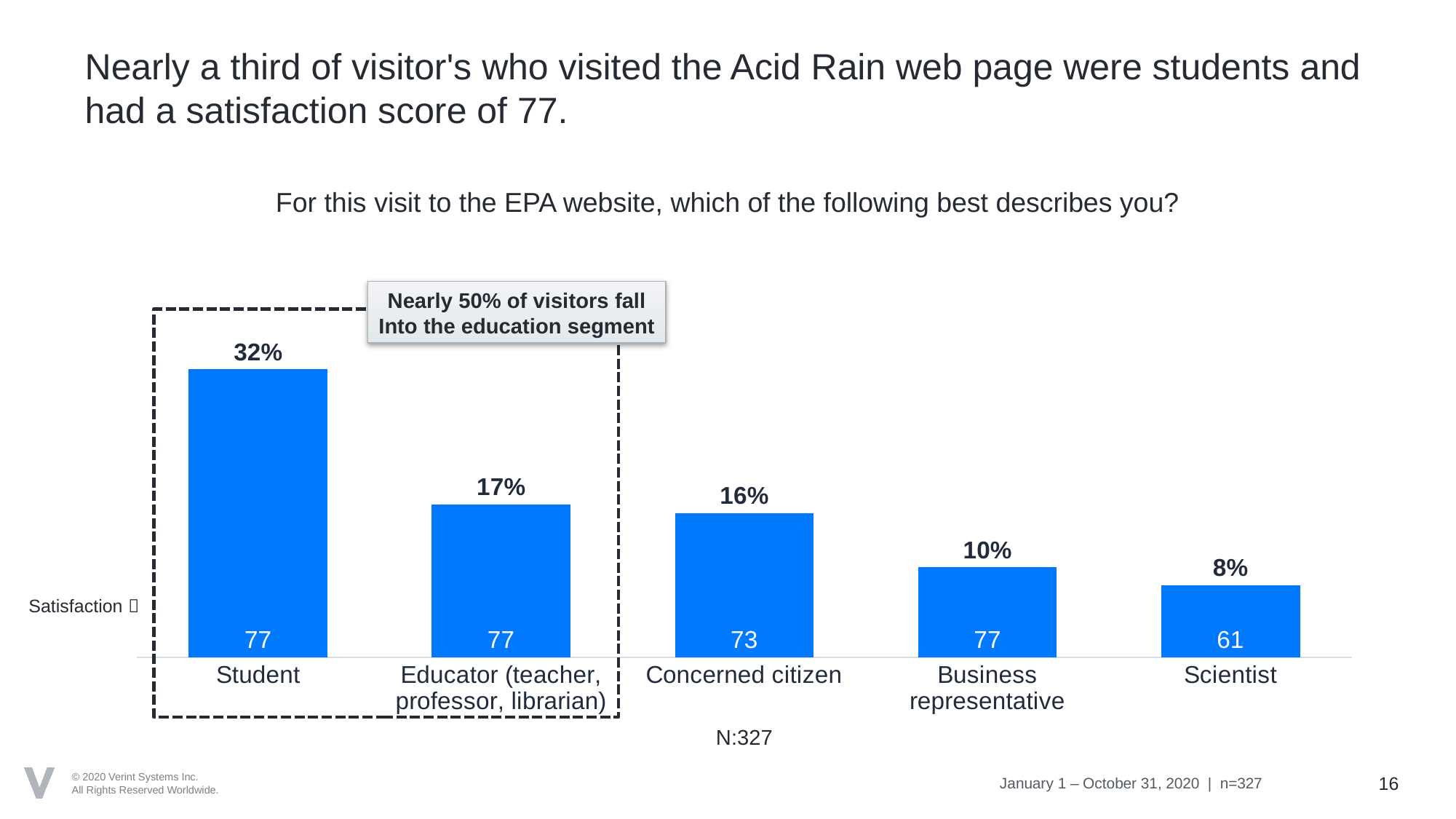
What percentage of visitors described themselves as Student? 32% What is the difference in percentage points between Student and Educator (teacher, professor, librarian)? 15% Do the percentage values rise or fall from left to right across the categories? Fall What is the satisfaction score shown for Scientist? 61 Which category has the highest percentage of visitors? Student Which has a larger share of visitors, Business representative or Scientist? Business representative What percentage of visitors described themselves as Concerned citizen? 16% Which category has the lowest percentage of visitors? Scientist How many categories are shown in the chart? 5 What kind of chart is shown on the slide? Bar chart What is the satisfaction score shown for Concerned citizen? 73 What is the combined percentage of visitors in the Student and Educator (teacher, professor, librarian) categories? 49%